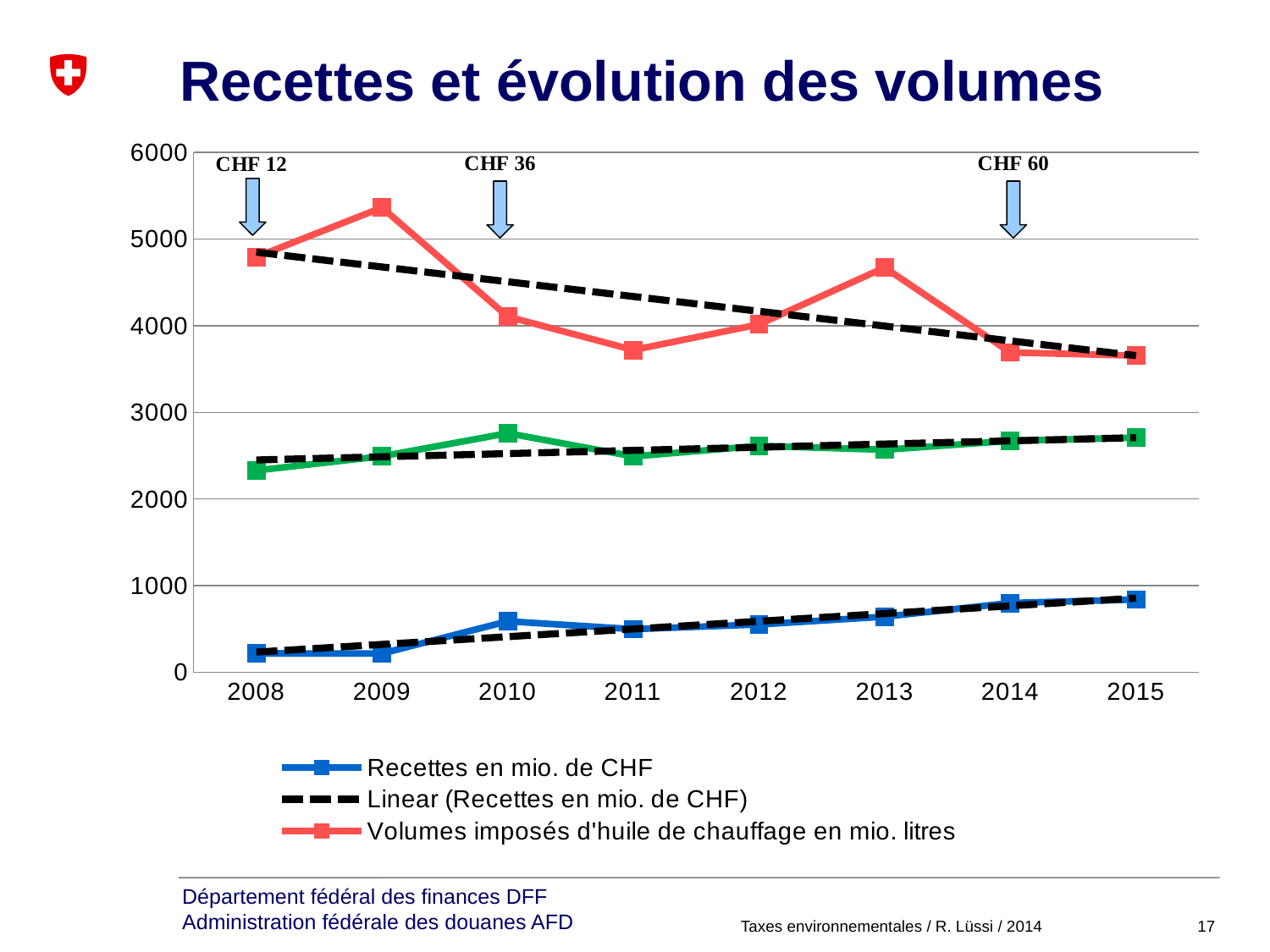
Does the linear trend line for 'Volumes imposés d'huile de chauffage en mio. litres' rise or fall from 2008 to 2015? fall Is the value for 'Volumes imposés d'huile de chauffage en mio. litres' in 2011 greater or less than 4000? less Is the value for 'Recettes en mio. de CHF' in 2015 greater or less than 1000? less What is the title of the chart on the slide? Recettes et évolution des volumes Which is larger for 'Recettes en mio. de CHF': the value in 2009 or the value in 2010? 2010 How many series does the legend list? 3 In which year is the value for 'Volumes imposés d'huile de chauffage en mio. litres' highest? 2009 How many years are plotted along the x axis? 8 What kind of chart is shown on the slide? line chart Which is larger for 'Volumes imposés d'huile de chauffage en mio. litres': the value in 2009 or the value in 2010? 2009 Is the value for 'Volumes imposés d'huile de chauffage en mio. litres' in 2009 greater or less than 5000? greater Do the values for 'Recettes en mio. de CHF' generally rise or fall from 2008 to 2015? rise